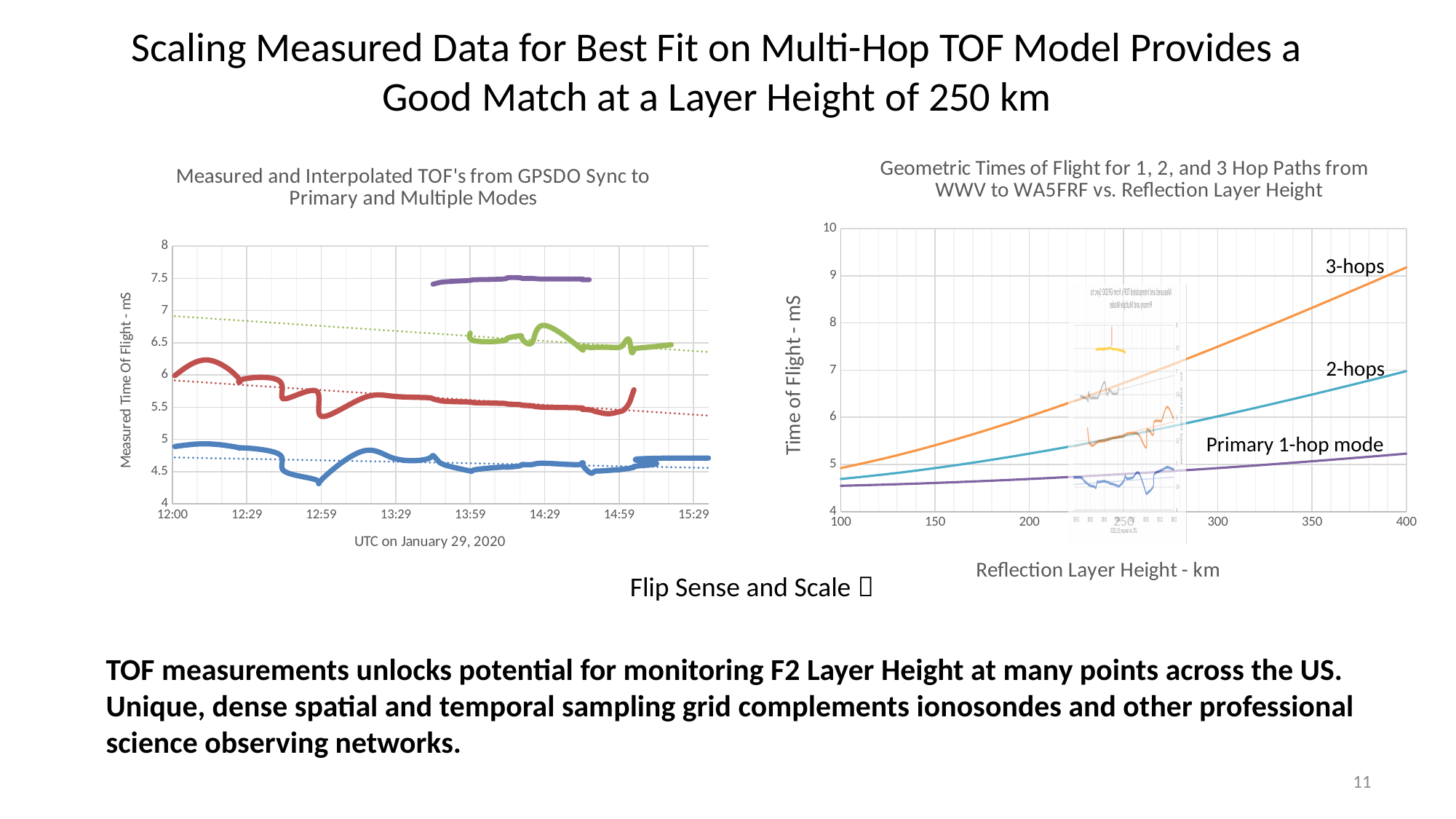
How many labeled hop-path curves are plotted in the right-hand chart? 3 In the left-hand chart, is the blue measured trace at 12:00 greater or less than 5 mS? less What kind of chart is the right-hand chart titled "Geometric Times of Flight for 1, 2, and 3 Hop Paths from WWV to WA5FRF vs. Reflection Layer Height"? line chart What is the x-axis label of the left-hand chart titled "Measured and Interpolated TOF's from GPSDO Sync to Primary and Multiple Modes"? UTC on January 29, 2020 In the right-hand chart, is the time of flight for the Primary 1-hop mode at 100 km greater or less than 5 mS? less In the right-hand chart, is the time of flight for the 3-hops path at 400 km greater or less than 9 mS? greater In the right-hand chart, do the time-of-flight curves rise or fall as reflection layer height increases from 100 to 400 km? rise In the right-hand chart, which labeled path has the lowest time of flight across the plotted range? Primary 1-hop mode What is the x-axis label of the right-hand chart? Reflection Layer Height - km In the right-hand chart, which labeled path has the highest time of flight at a reflection layer height of 400 km? 3-hops In the right-hand chart, at a reflection layer height of 300 km, which is larger: the time of flight for 2-hops or for Primary 1-hop mode? 2-hops